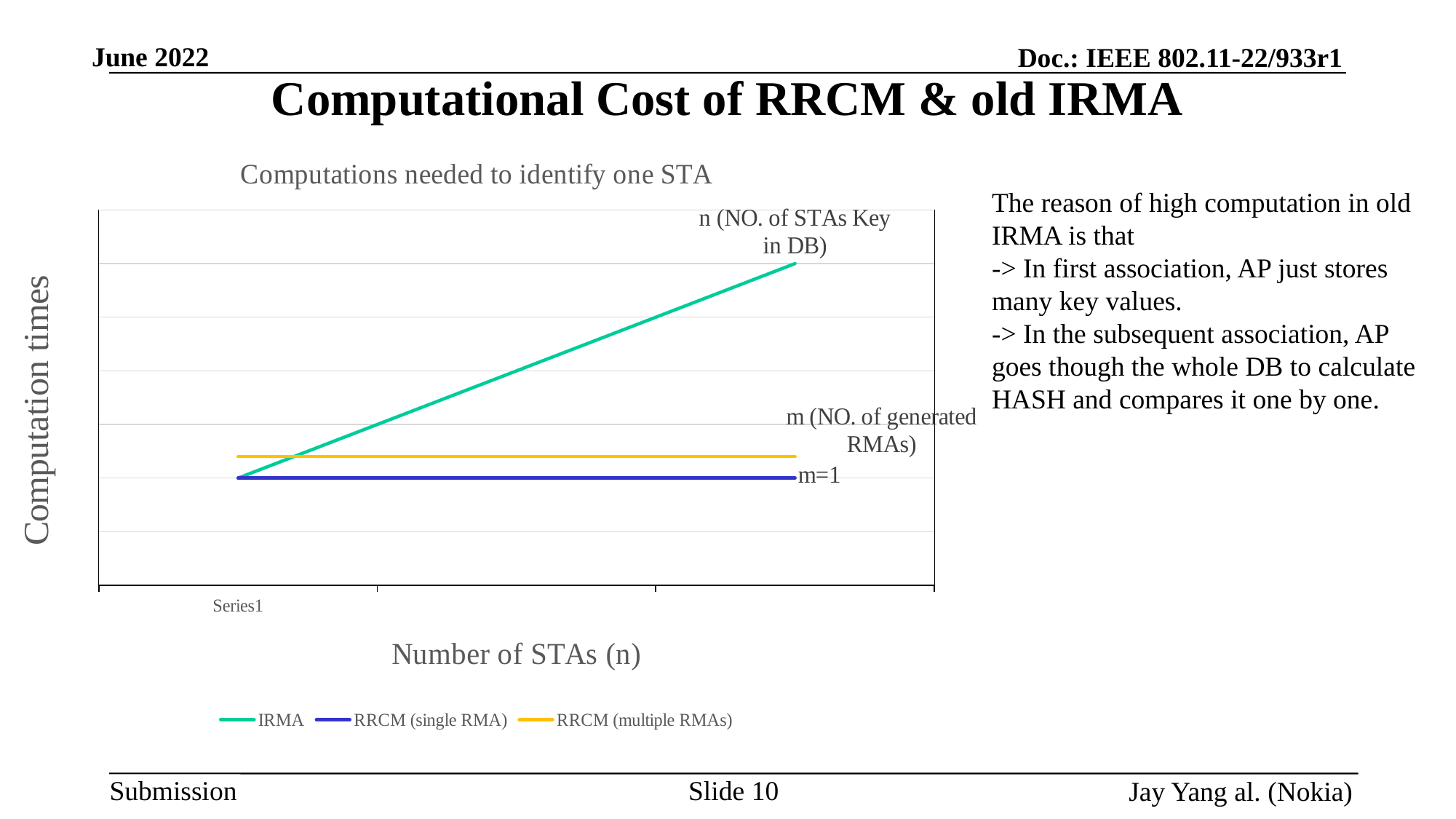
Which series is drawn in green? IRMA How many series does the legend list? 3 At the right end of the chart, which is higher: IRMA or RRCM (multiple RMAs)? IRMA What annotation is written at the right end of the RRCM (single RMA) line? m=1 Which series has the highest computation times at the right end of the chart? IRMA Which series has the lowest computation times across the chart? RRCM (single RMA) What kind of chart is shown on the slide? line chart Does the RRCM (single RMA) line rise, fall, or stay flat as the number of STAs increases? stay flat Does the IRMA line rise or fall as the number of STAs increases? rise What is the label of the x axis? Number of STAs (n) Which line is higher: RRCM (multiple RMAs) or RRCM (single RMA)? RRCM (multiple RMAs) What is the title of the chart? Computations needed to identify one STA